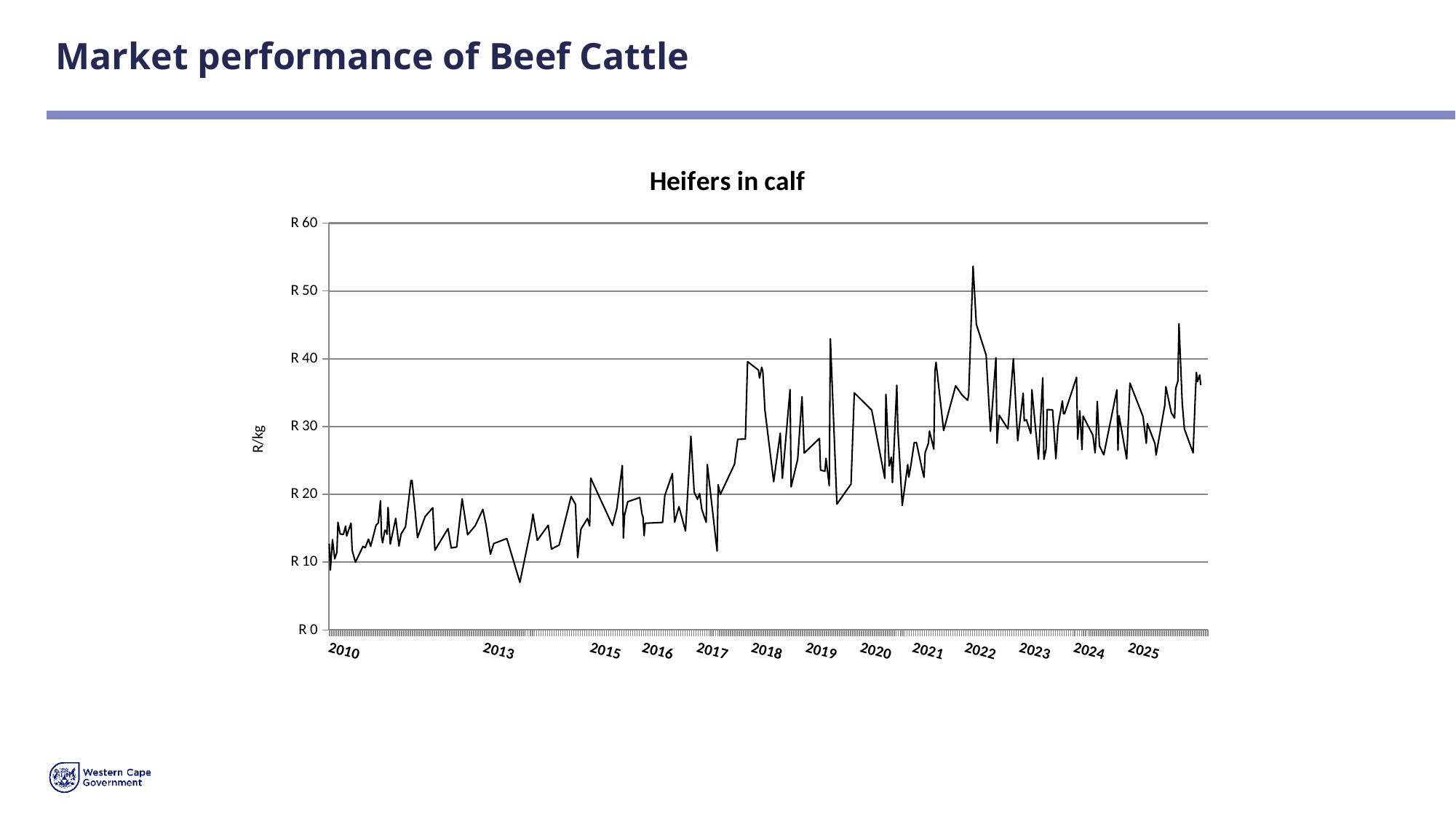
What is the last year labelled on the horizontal axis? 2025 What is the highest value shown on the vertical axis? R 60 What is the label on the vertical axis of the chart? R/kg Which period has higher values, 2010 or 2025? 2025 In which labelled year does the line reach its highest peak? 2022 What is the first year labelled on the horizontal axis? 2010 Is the highest peak of the line, in 2022, greater or less than R 50? greater Are the values at the start of the series in 2010 greater or less than R 20? less What kind of chart is shown on the slide? line chart What is the title of the chart? Heifers in calf Is the lowest point of the line, near 2013, greater or less than R 10? less Overall, do the values rise or fall from 2010 to 2025? rise